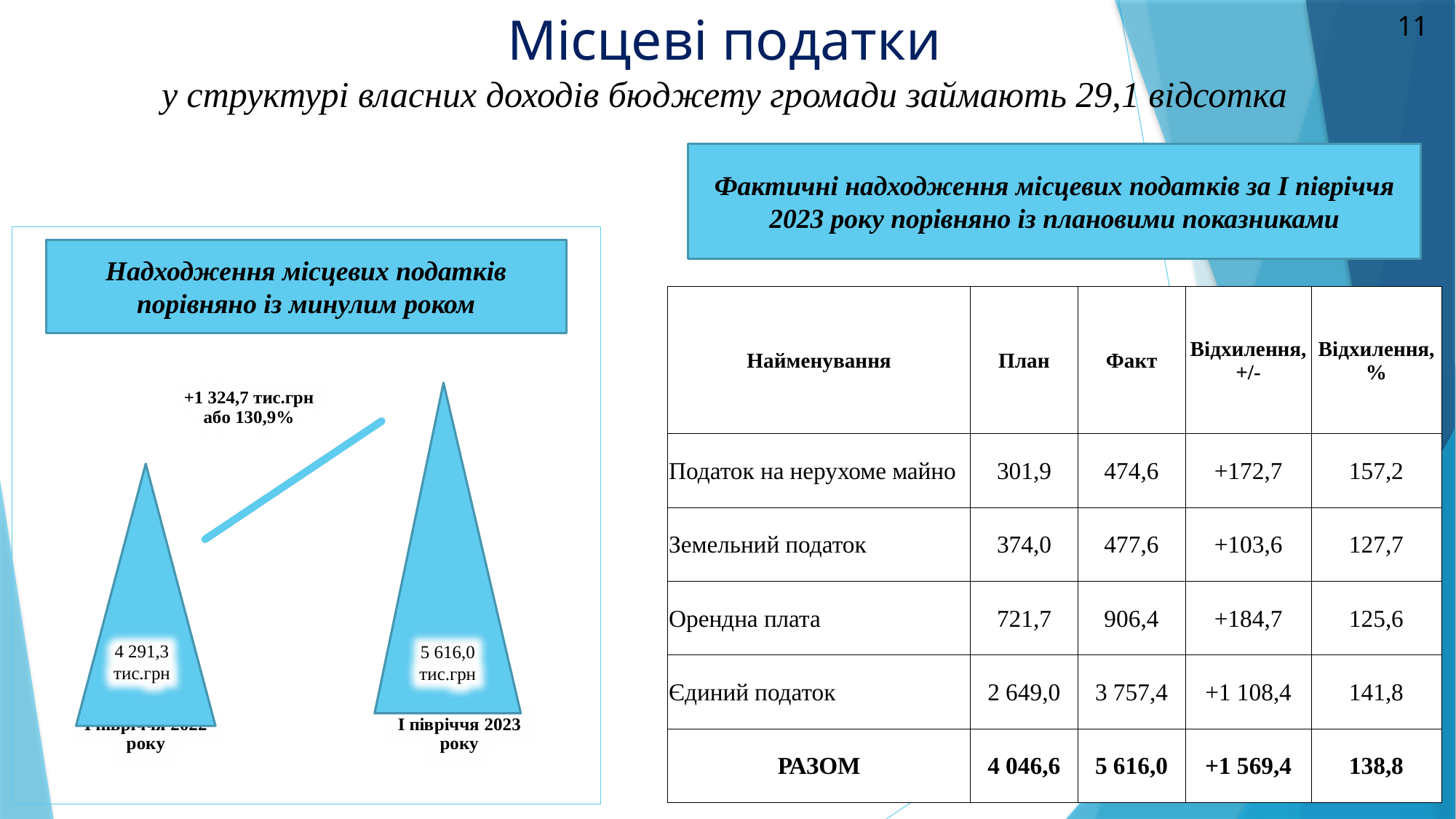
In the chart 'Надходження місцевих податків порівняно із минулим роком', what is the difference between the value for І півріччя 2023 року and І півріччя 2022 року? 1 324,7 тис.грн What kind of chart is 'Надходження місцевих податків порівняно із минулим роком'? pyramid (triangle) chart In the chart 'Надходження місцевих податків порівняно із минулим роком', which period has the higher value? І півріччя 2023 року In the chart 'Надходження місцевих податків порівняно із минулим роком', what percentage growth is shown in the annotation next to the arrow? 130,9% In the chart 'Надходження місцевих податків порівняно із минулим роком', do the values rise or fall from І півріччя 2022 року to І півріччя 2023 року? rise What colour are the bars in the chart 'Надходження місцевих податків порівняно із минулим роком'? light blue What is the title of the chart on the left side of the slide? Надходження місцевих податків порівняно із минулим роком In the chart 'Надходження місцевих податків порівняно із минулим роком', is the value for І півріччя 2023 року larger or smaller than the value for І півріччя 2022 року? larger In the chart 'Надходження місцевих податків порівняно із минулим роком', what is the value for І півріччя 2023 року? 5 616,0 тис.грн In the chart 'Надходження місцевих податків порівняно із минулим роком', which period has the lower value? І півріччя 2022 року In the chart 'Надходження місцевих податків порівняно із минулим роком', what is the value for І півріччя 2022 року? 4 291,3 тис.грн How many periods (categories) are shown in the chart 'Надходження місцевих податків порівняно із минулим роком'? 2